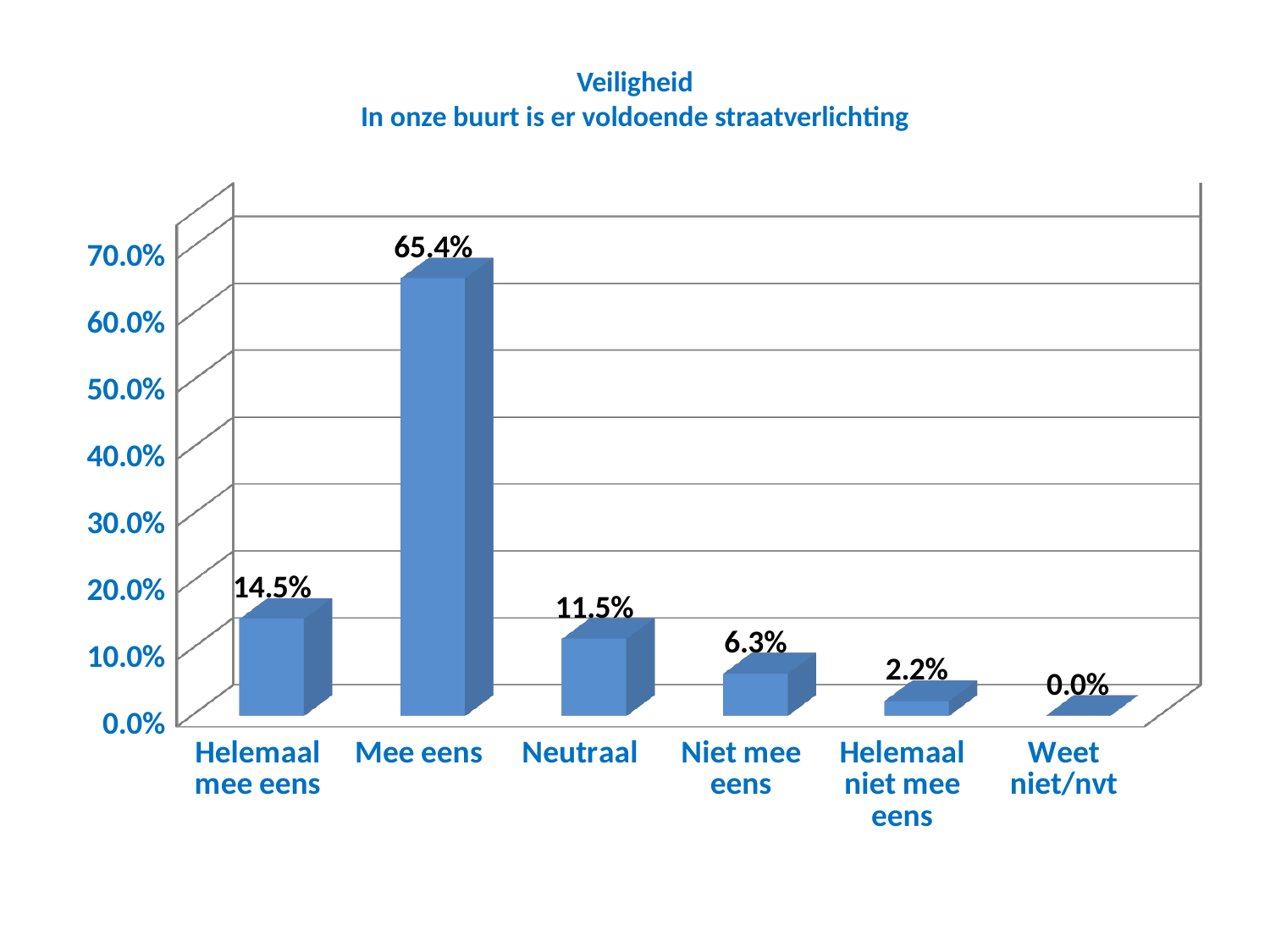
What is the value for "Neutraal"? 11.5% What is the value for "Mee eens"? 65.4% Which category has the highest value? Mee eens Which category has the lowest value? Weet niet/nvt What is the title of the chart? Veiligheid In onze buurt is er voldoende straatverlichting What is the value for "Helemaal niet mee eens"? 2.2% What is the value for "Helemaal mee eens"? 14.5% What is the difference between the values for "Mee eens" and "Helemaal mee eens"? 50.9% What is the value for "Weet niet/nvt"? 0.0% Which is larger, the value for "Neutraal" or the value for "Niet mee eens"? Neutraal How many categories are shown on the x axis? 6 What kind of chart is shown on the slide? Bar chart